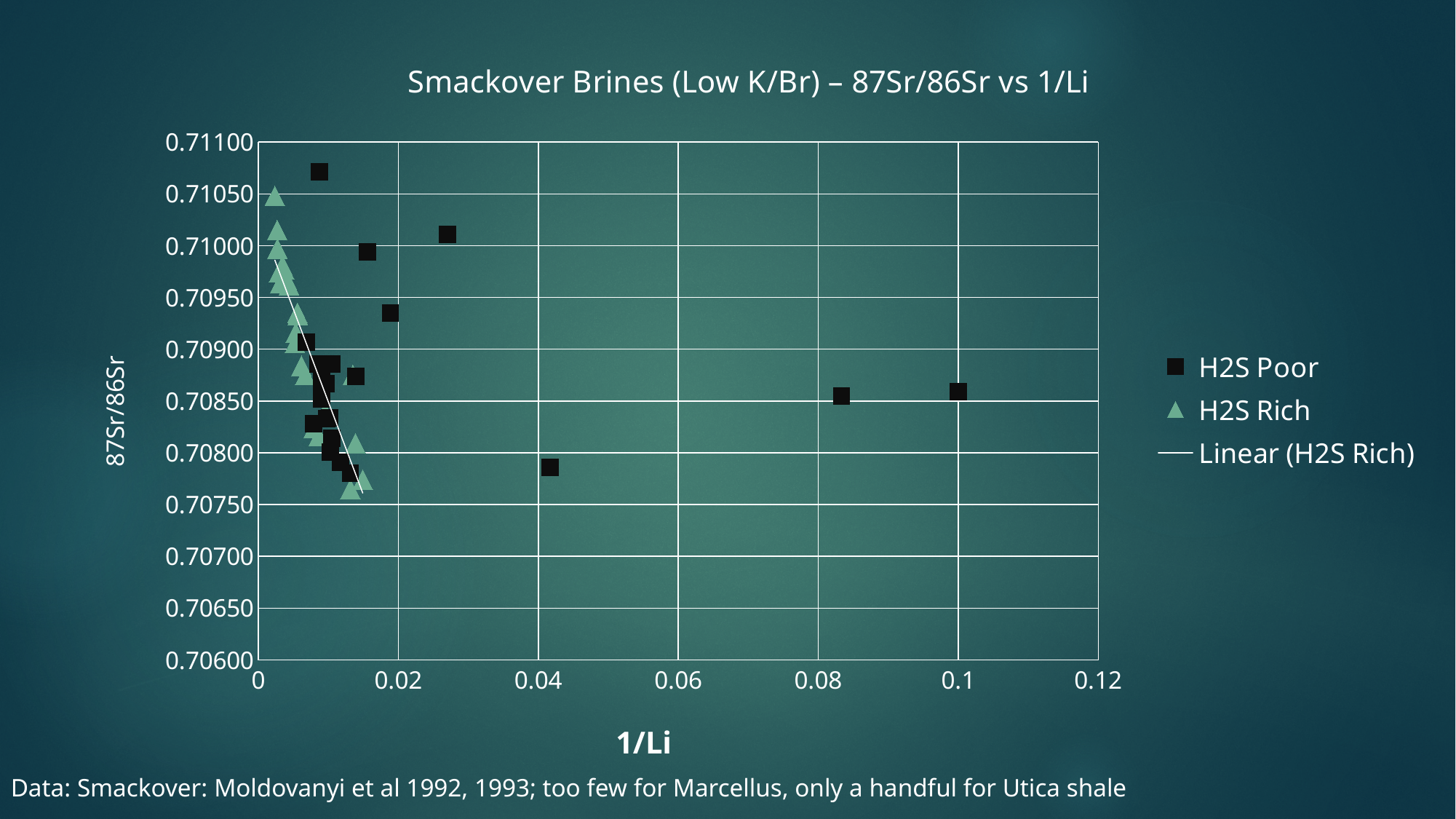
What is the title of the chart? Smackover Brines (Low K/Br) – 87Sr/86Sr vs 1/Li Is the 87Sr/86Sr value of the highest H2S Poor point greater or less than 0.71050? greater Does the Linear (H2S Rich) trendline rise or fall as 1/Li increases? Falls Is the 87Sr/86Sr value of the lowest H2S Rich point greater or less than 0.70800? less What kind of chart is shown on the slide? Scatter chart How many H2S Poor points have a 1/Li value greater than 0.04? 3 How many entries does the chart legend list? 3 Which has the higher 87Sr/86Sr value: the H2S Poor point near 1/Li = 0.027 or the H2S Poor point near 1/Li = 0.042? The point near 1/Li = 0.027 Is the 87Sr/86Sr value of the H2S Poor point near 1/Li = 0.042 greater or less than 0.70850? less What are the entries listed in the legend? H2S Poor, H2S Rich, Linear (H2S Rich) Which series contains the point with the largest 1/Li value? H2S Poor